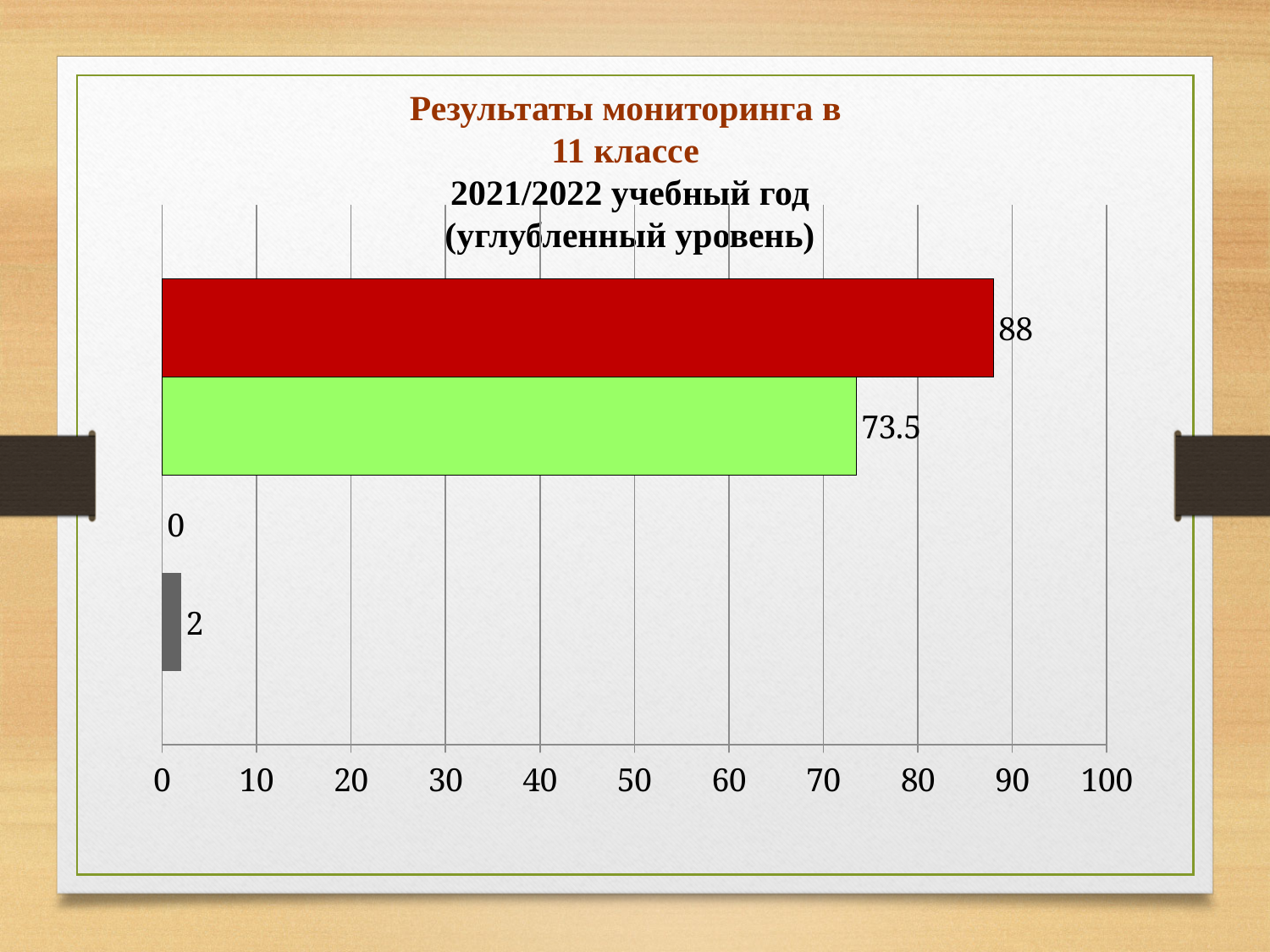
How many data labels are shown on the chart? 4 Which is larger, the red bar or the light green bar? the red bar Which bar has the highest value? the red bar (88) Is the value of the light green bar greater or less than 70? greater What is the value of the grey bar at the bottom of the chart? 2 What is the title of the chart? 2021/2022 учебный год (углубленный уровень) What is the maximum value shown on the horizontal axis? 100 What is the difference between the red bar and the light green bar? 14.5 What type of chart is shown on the slide? bar chart What is the value of the light green bar? 73.5 What is the value of the red bar? 88 What value is labelled for the third bar from the top? 0